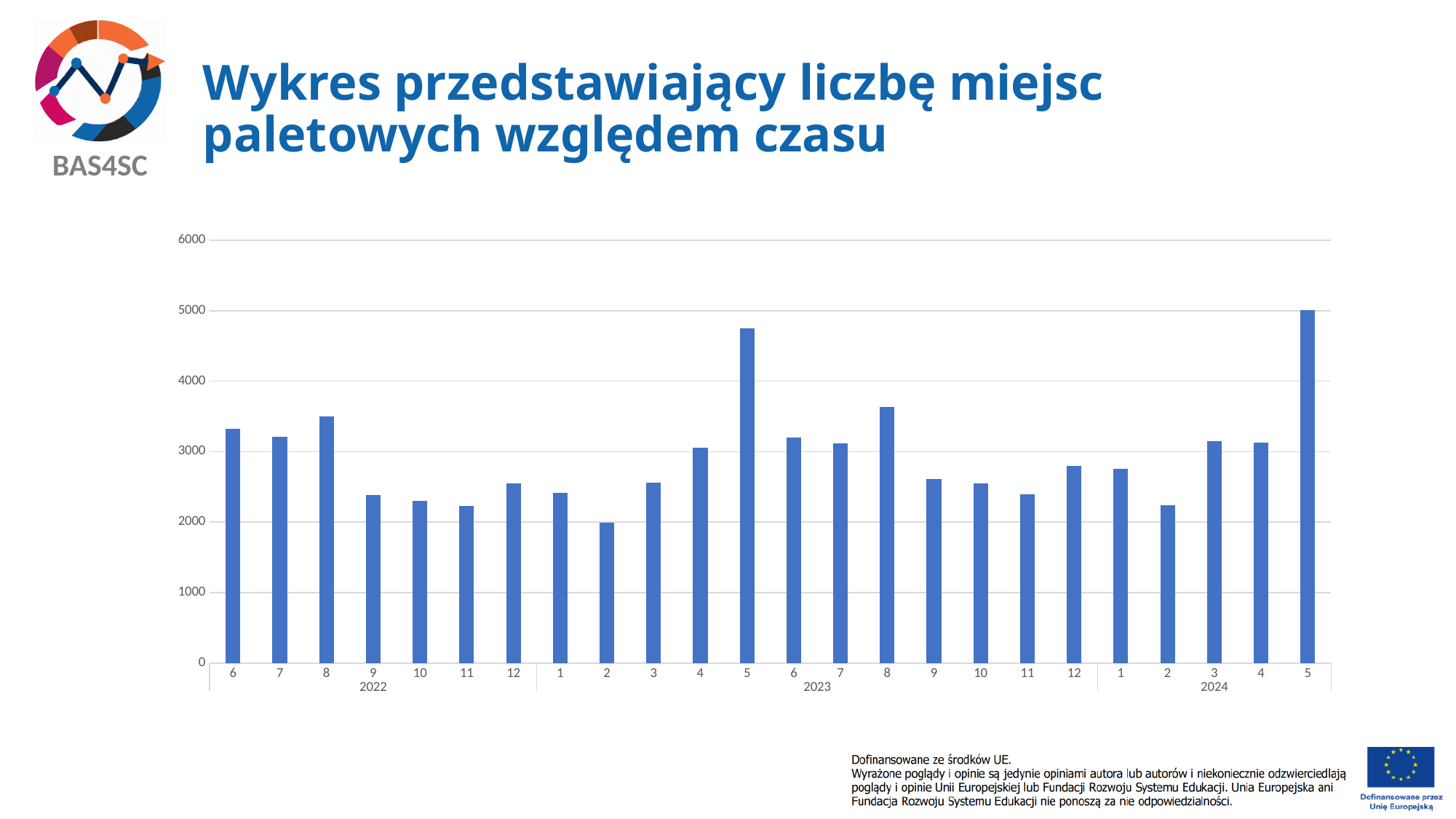
Which is larger: the value for month 8 of 2022 or month 9 of 2022? month 8 of 2022 Which month has the lowest number of pallet places in the chart? 2 (2023) Do the values rise or fall from month 2 of 2023 to month 5 of 2023? rise How many bars (months) are plotted in the chart? 24 Is the value for month 9 of 2022 greater or less than 3000? less Is the value for month 8 of 2023 greater or less than 3000? greater Which is larger: the value for month 5 of 2023 or month 8 of 2023? month 5 of 2023 What kind of chart is shown on the slide? bar chart Which month has the highest number of pallet places in the chart? 5 (2024) Is the value for month 11 of 2022 greater or less than 2000? greater What is the title of the chart on the slide? Wykres przedstawiający liczbę miejsc paletowych względem czasu